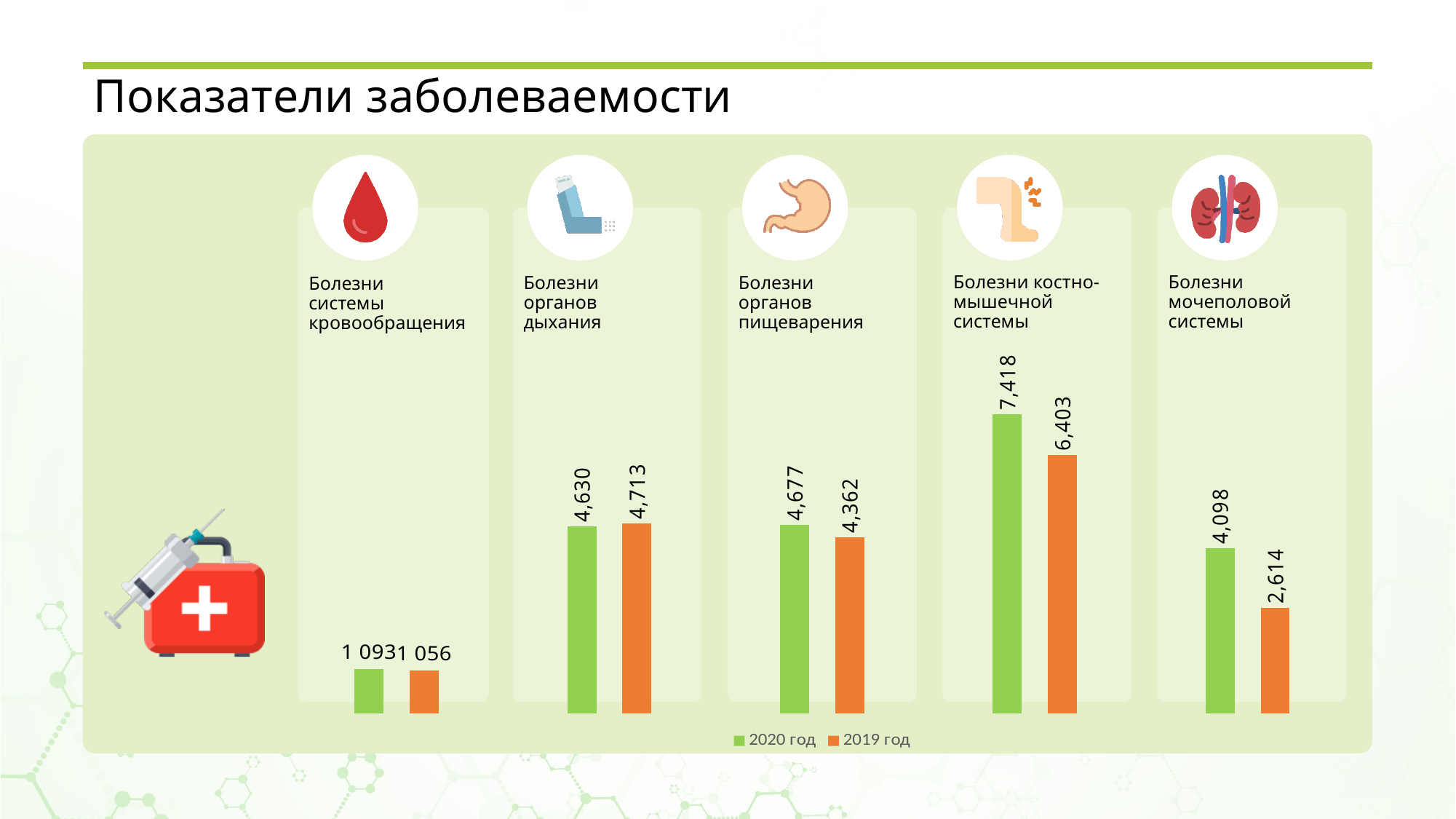
Which category has the lowest 2019 год value? Болезни системы кровообращения For Болезни органов дыхания, which is larger: the 2020 год value or the 2019 год value? 2019 год How many disease categories are shown in the chart? 5 What is the 2019 год value for Болезни органов дыхания? 4,713 What is the 2019 год value for Болезни мочеполовой системы? 2,614 How many series does the legend list? 2 What type of chart is shown on the slide? Bar chart What is the 2020 год value for Болезни костно-мышечной системы? 7,418 What is the 2020 год value for Болезни органов пищеварения? 4,677 Which category has the highest 2020 год value? Болезни костно-мышечной системы What is the difference between the 2020 год and 2019 год values for Болезни мочеполовой системы? 1,484 What is the difference between the 2020 год and 2019 год values for Болезни костно-мышечной системы? 1,015